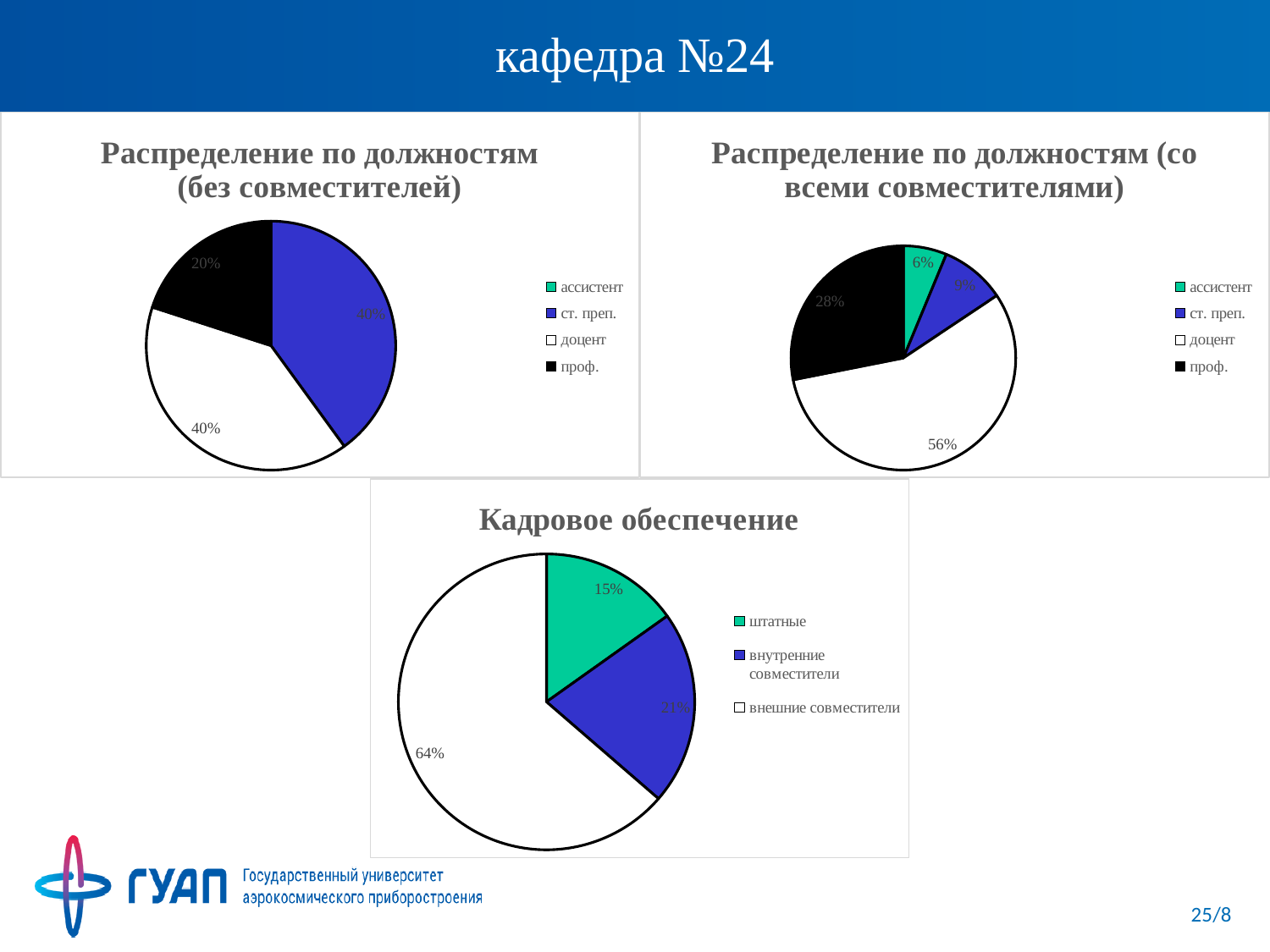
What type of chart is the chart titled "Кадровое обеспечение"? pie chart In the chart titled "Распределение по должностям (со всеми совместителями)", what share is labelled for ассистент? 6% In the chart titled "Кадровое обеспечение", how many categories does the legend list? 3 In the chart titled "Распределение по должностям (со всеми совместителями)", which category has the smallest slice? ассистент In the chart titled "Распределение по должностям (без совместителей)", which is larger, the slice for доцент or the slice for проф.? доцент In the chart titled "Распределение по должностям (без совместителей)", what share is labelled for проф.? 20% In the chart titled "Распределение по должностям (со всеми совместителями)", which category has the largest slice? доцент In the chart titled "Распределение по должностям (со всеми совместителями)", what share is labelled for проф.? 28% In the chart titled "Распределение по должностям (со всеми совместителями)", what is the difference between the shares for доцент and проф.? 28% In the chart titled "Распределение по должностям (со всеми совместителями)", what share is labelled for доцент? 56% In the chart titled "Кадровое обеспечение", what share is labelled for внешние совместители? 64% In the chart titled "Кадровое обеспечение", what share is labelled for штатные? 15%